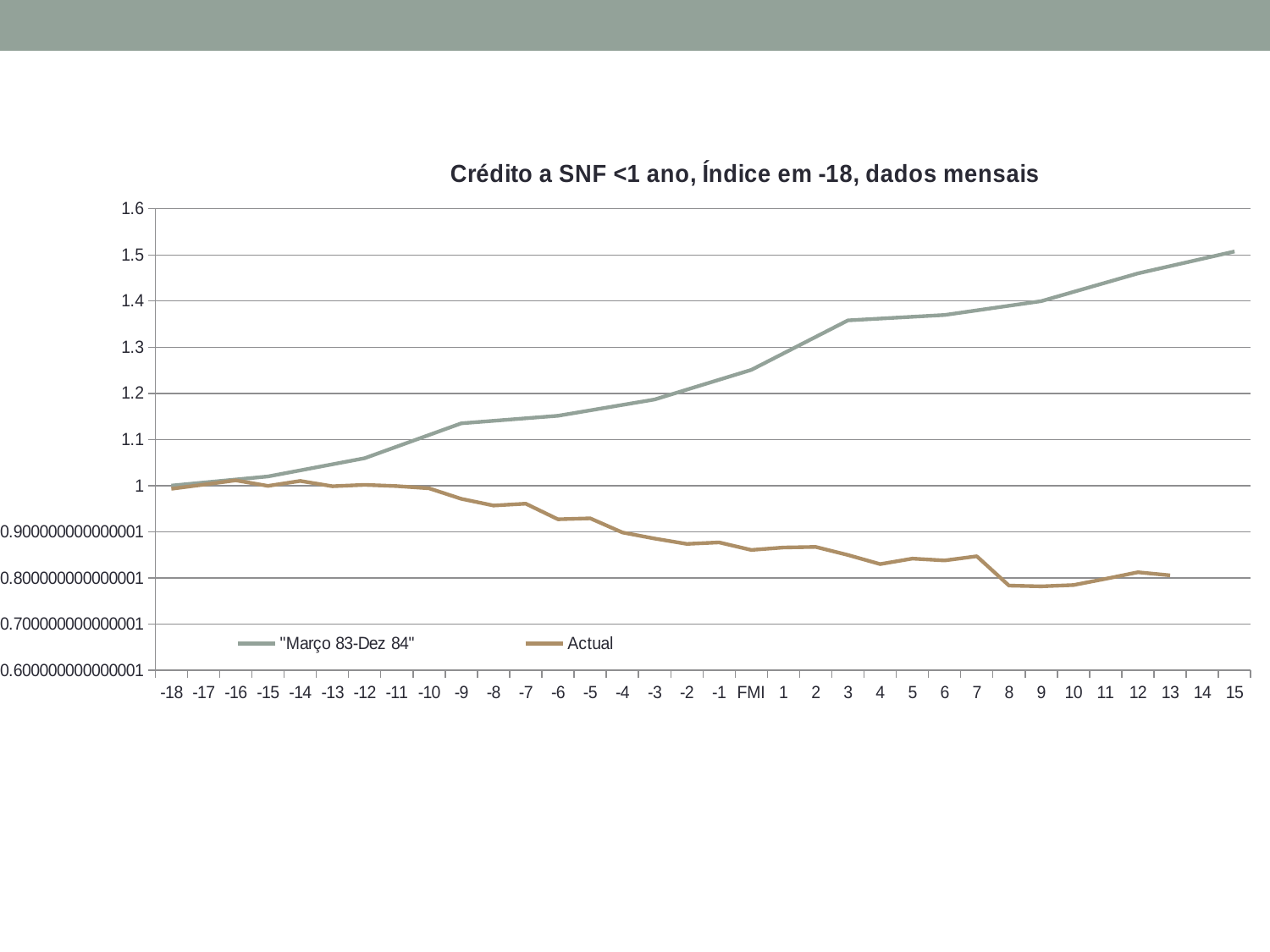
Does the "Março 83-Dez 84" series rise or fall along the x axis? rise Is the value of "Março 83-Dez 84" at 3 greater or less than 1.3? greater How many series does the legend list? 2 What kind of chart is shown on the slide? line chart At which x-axis point does the "Março 83-Dez 84" series reach its highest value? 15 Does the Actual series generally rise or fall along the x axis? fall Is the value of Actual at 4 greater or less than 0.9? less Is the value of "Março 83-Dez 84" at -9 greater or less than 1.1? greater What is the title of the chart? Crédito a SNF <1 ano, Índice em -18, dados mensais What are the two series named in the legend? "Março 83-Dez 84" and Actual At FMI, which series has the larger value, "Março 83-Dez 84" or Actual? "Março 83-Dez 84"